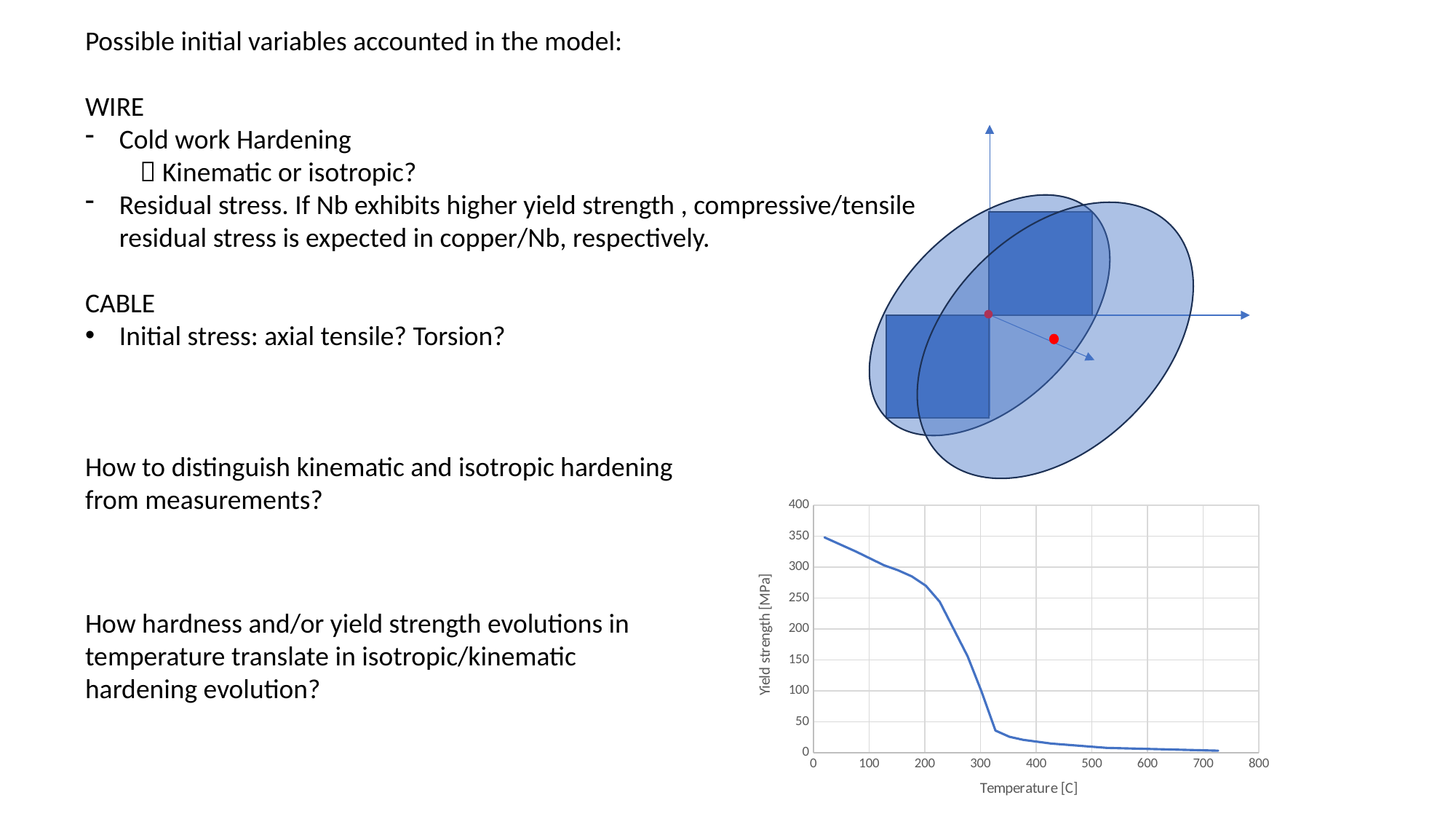
In the bottom-right chart, is the yield strength at the lowest plotted temperature greater or less than 300 MPa? greater What is the label of the horizontal axis of the bottom-right chart? Temperature [C] In the bottom-right chart, which is larger: the yield strength at 100 C or at 500 C? 100 C What kind of chart is shown at the bottom right of the slide? line chart In the bottom-right chart, is the yield strength at 300 C greater or less than 150 MPa? less In the bottom-right chart, is the yield strength at 400 C greater or less than 50 MPa? less In the bottom-right chart, does yield strength rise or fall as temperature increases? fall What is the label of the vertical axis of the bottom-right chart? Yield strength [MPa]